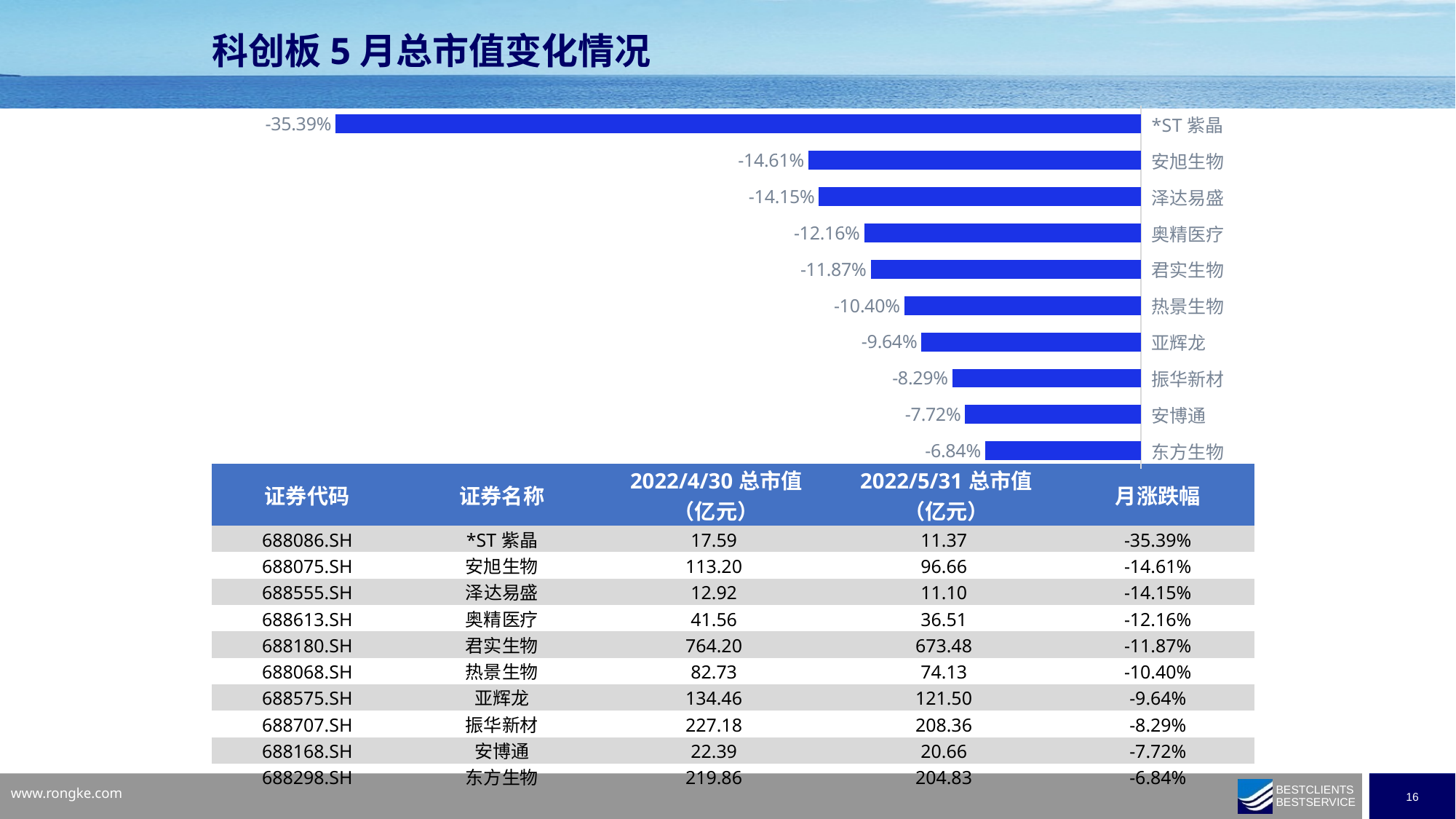
What is the monthly change shown for 亚辉龙 in the bar chart? -9.64% Which company has the highest (least negative) monthly change in the bar chart? 东方生物 What is the monthly change shown for 东方生物 in the bar chart? -6.84% What is the monthly change shown for *ST 紫晶 in the bar chart? -35.39% Which company has the lowest (most negative) monthly change in the bar chart? *ST 紫晶 What is the monthly change shown for 君实生物 in the bar chart? -11.87% Which has the larger (less negative) monthly change in the bar chart, 奥精医疗 or 君实生物? 君实生物 What is the title of the slide containing the bar chart? 科创板 5 月总市值变化情况 What is the difference in percentage points between the monthly change of 东方生物 (-6.84%) and *ST 紫晶 (-35.39%)? 28.55 percentage points What kind of chart is shown on the slide? bar chart How many companies are plotted in the bar chart? 10 What is the difference in percentage points between the monthly change of 安旭生物 (-14.61%) and 泽达易盛 (-14.15%)? 0.46 percentage points